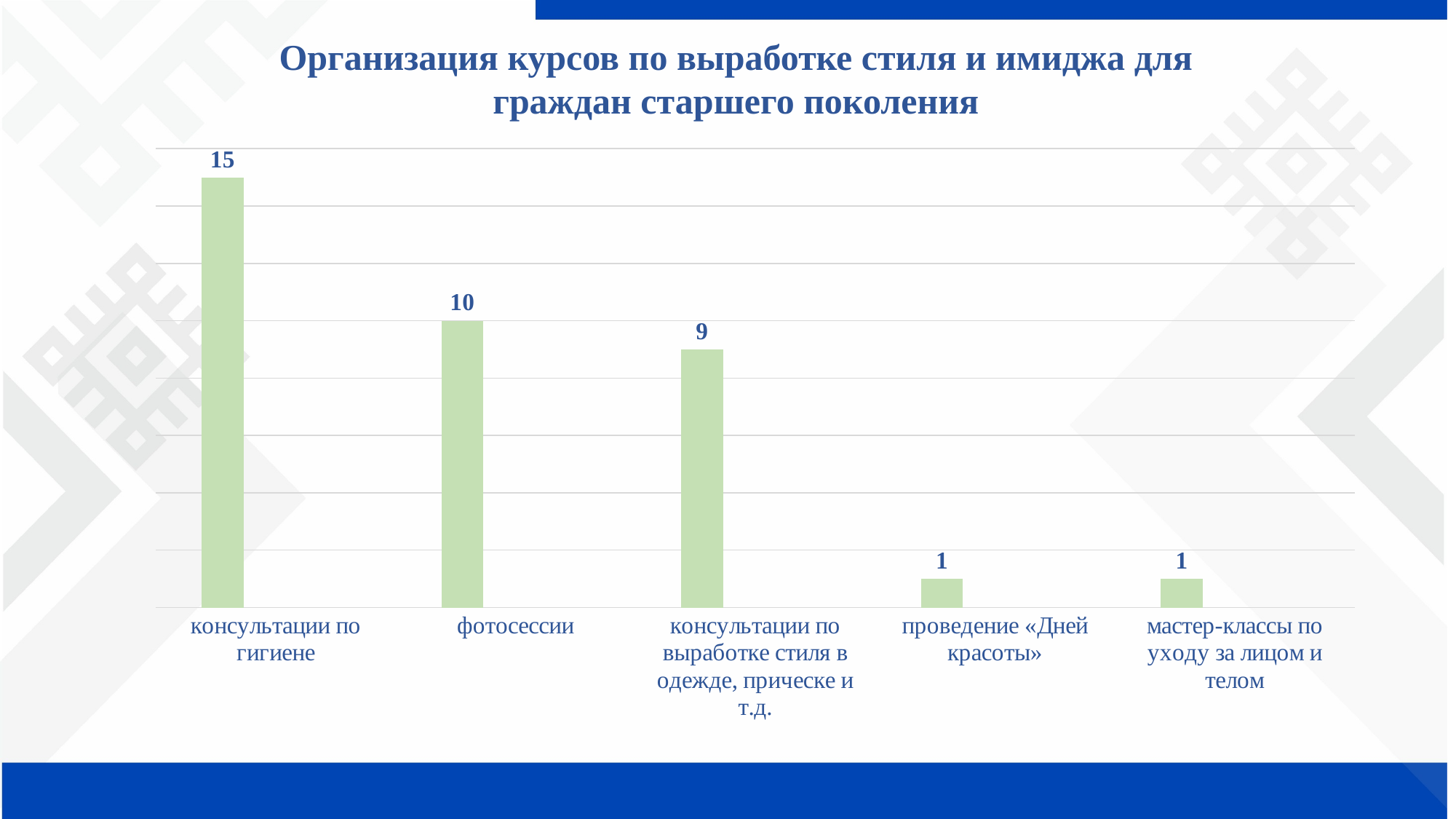
What is the value for «фотосессии»? 10 What is the difference between the values for «фотосессии» and «консультации по выработке стиля в одежде, прическе и т.д.»? 1 Which is larger: the value for «фотосессии» or the value for «проведение «Дней красоты»»? фотосессии What type of chart is shown on the slide? bar chart What is the value for «мастер-классы по уходу за лицом и телом»? 1 What is the value for «проведение «Дней красоты»»? 1 Which category has the highest value? консультации по гигиене What is the title of the chart? Организация курсов по выработке стиля и имиджа для граждан старшего поколения How many categories are shown in the chart? 5 What is the value for «консультации по выработке стиля в одежде, прическе и т.д.»? 9 What is the value for «консультации по гигиене»? 15 What is the difference between the values for «консультации по гигиене» and «фотосессии»? 5